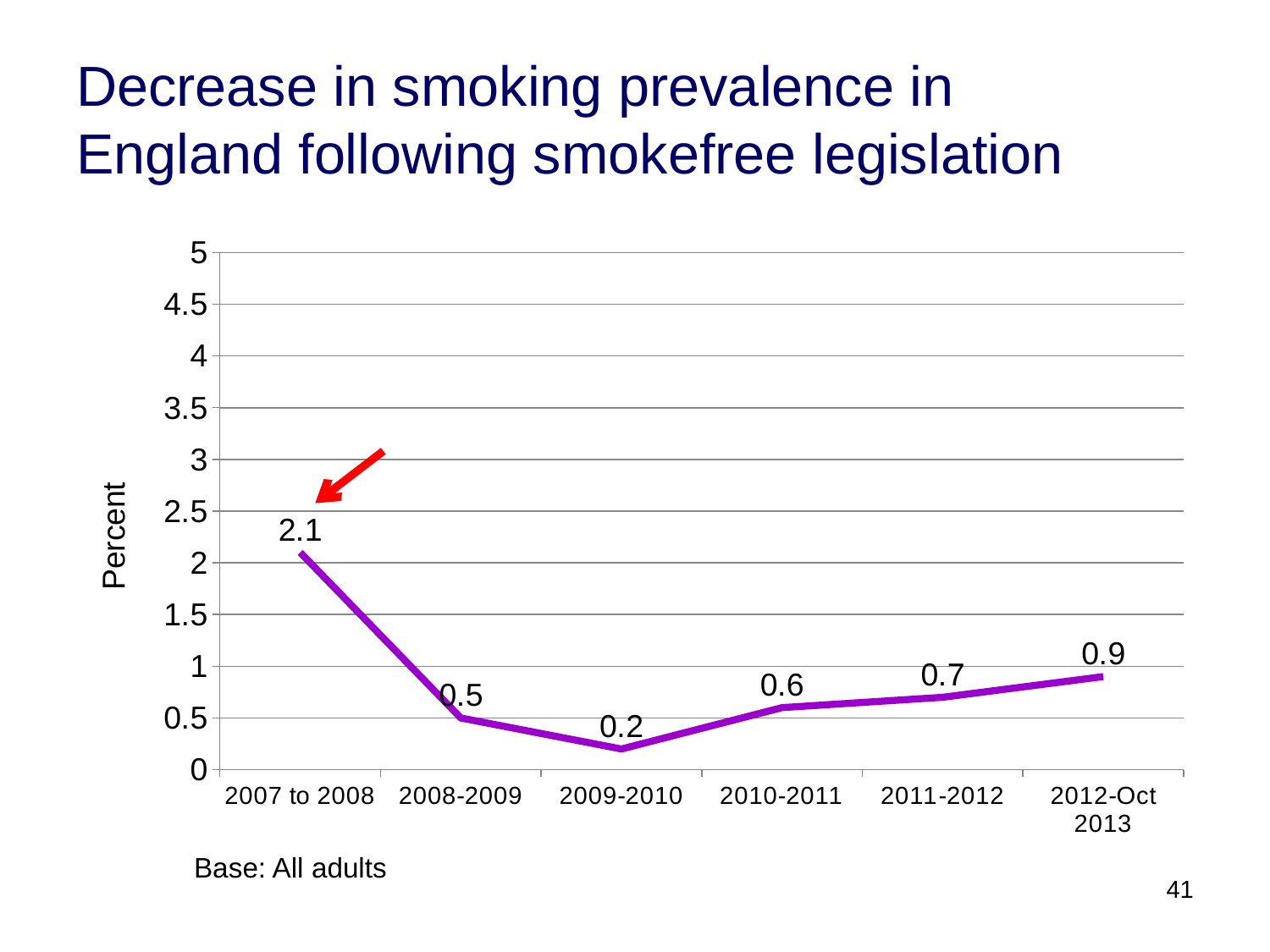
What is the difference between the values for 2007 to 2008 and 2008-2009? 1.6 Which is larger, the value for 2010-2011 or the value for 2011-2012? 2011-2012 What is the value for 2012-Oct 2013? 0.9 How many periods are plotted on the x axis? 6 Which period has the lowest value? 2009-2010 What is the label on the y axis? Percent What kind of chart is shown? line chart What is the value for 2009-2010? 0.2 Is the value for 2007 to 2008 greater or less than 1.5? greater Which period has the highest value? 2007 to 2008 Do the values rise or fall from 2009-2010 to 2012-Oct 2013? rise What is the value for 2007 to 2008? 2.1